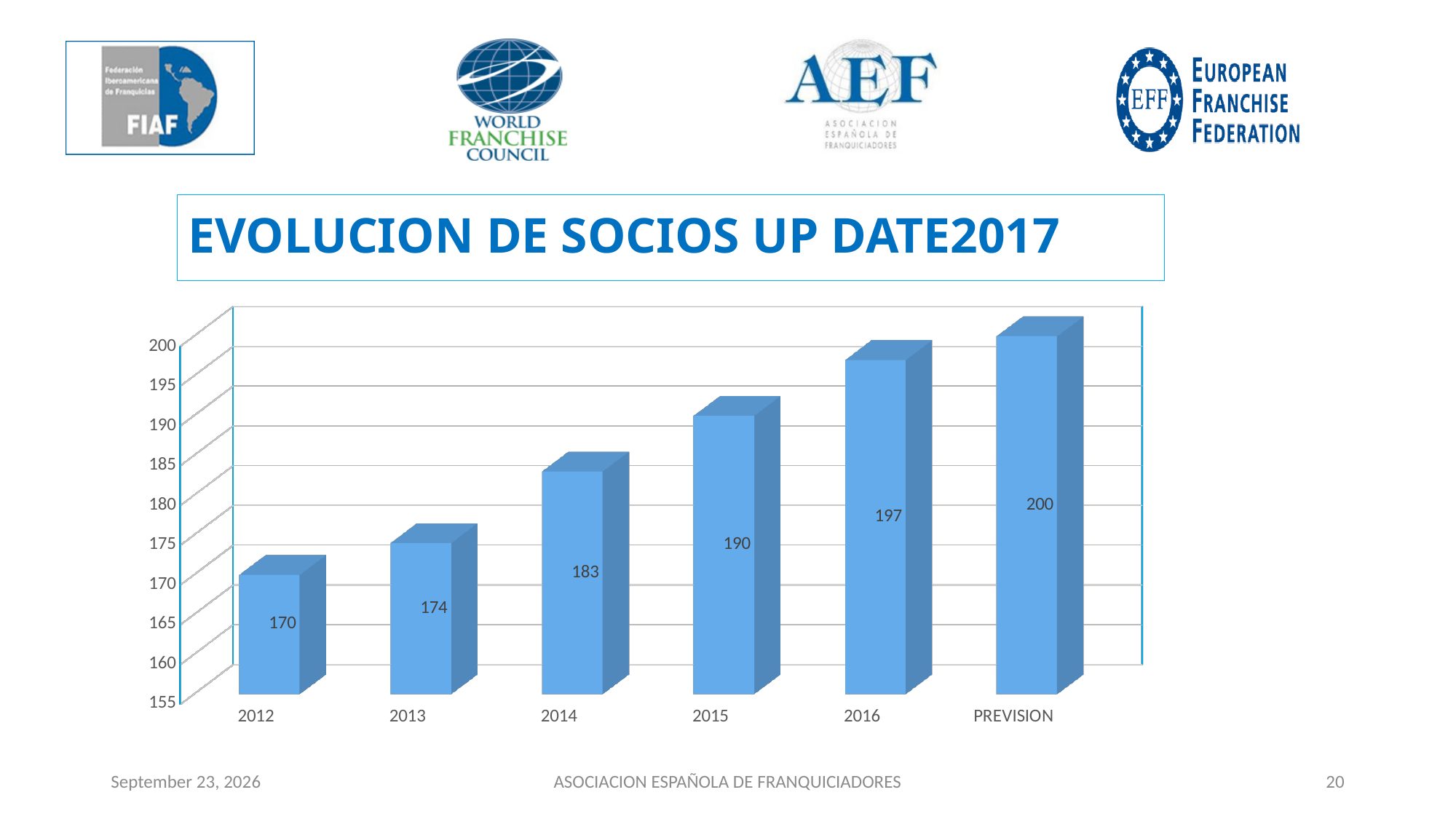
Which category has the highest value? PREVISION What is the difference between the values for 2016 and 2012? 27 What kind of chart is shown on the slide? bar chart What is the difference between the values for 2015 and 2014? 7 What is the value for 2016? 197 Is the value for 2014 greater or less than 180? greater Which category has the lowest value? 2012 What is the value for PREVISION? 200 Which is larger, the value for 2013 or the value for 2015? 2015 How many categories are shown on the x axis? 6 Do the values rise or fall from 2012 to PREVISION? rise What is the value for 2014? 183